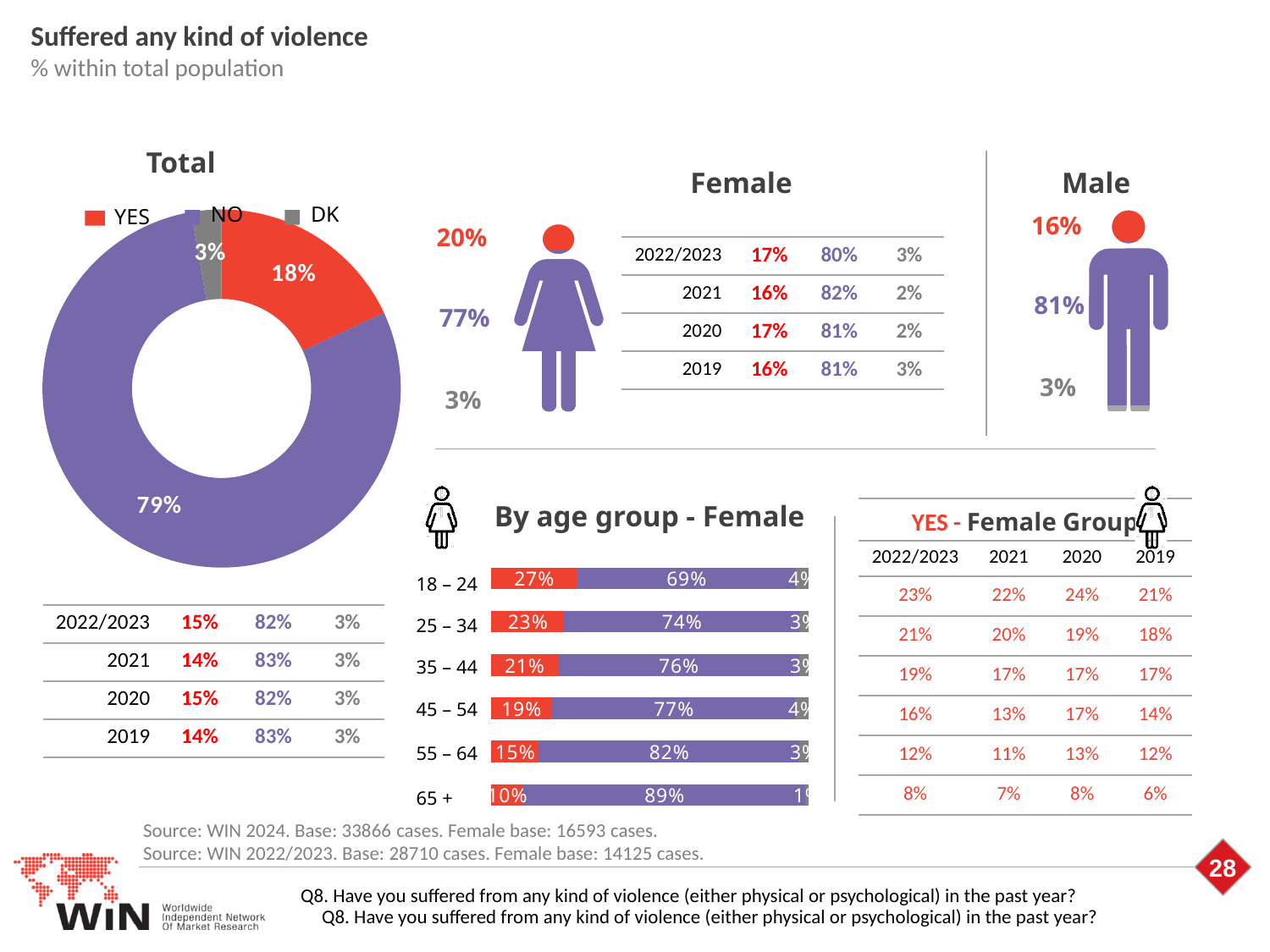
In the By age group - Female chart, which age group has the highest YES percentage? 18 – 24 In the By age group - Female chart, does the YES percentage rise or fall as age increases? Falls In the By age group - Female chart, what is the NO percentage for the 65 + age group? 89% In the By age group - Female chart, which age group has the lowest YES percentage? 65 + In the Total donut chart, what percentage answered YES? 18% In the By age group - Female chart, what is the difference between the YES percentage for 18 – 24 and for 65 +? 17 percentage points In the By age group - Female chart, how many age groups are shown? 6 In the Total donut chart, which category has the smallest share? DK In the Total donut chart, how many categories does the legend list? 3 In the Total donut chart, what percentage answered NO? 79% What kind of chart is the Total chart? Donut (pie) chart In the By age group - Female chart, what is the YES percentage for the 18 – 24 age group? 27%